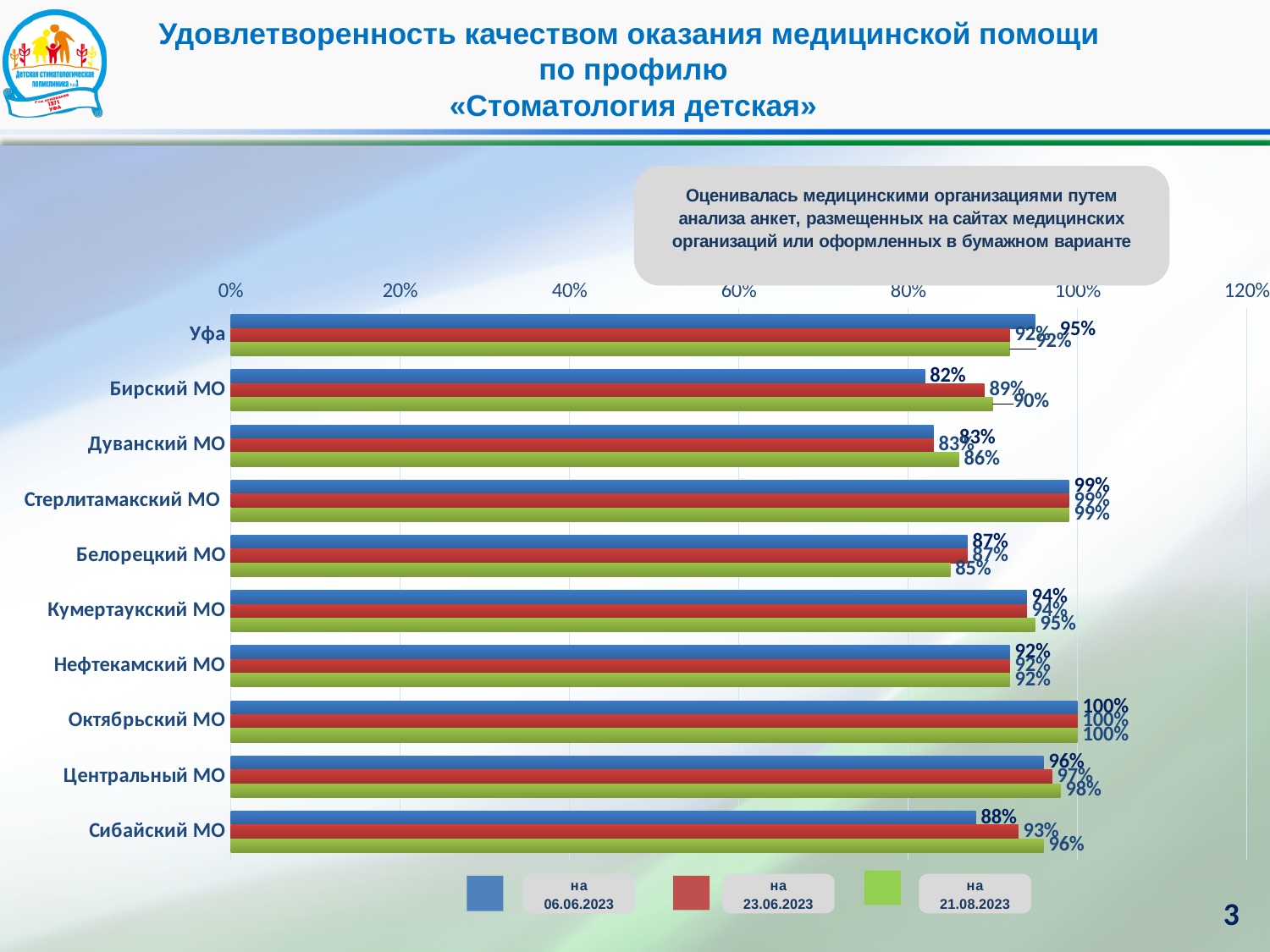
Which category has the highest value for the series на 06.06.2023? Октябрьский МО Is the value for Бирский МО for the series на 06.06.2023 greater or less than 80%? greater How many categories (medical organisations) are plotted on the chart? 10 What is the value for Сибайский МО for the series на 21.08.2023? 96% What is the value for Октябрьский МО for the series на 06.06.2023? 100% How many series does the legend list? 3 What is the difference between the values for Сибайский МО on 21.08.2023 and on 06.06.2023? 8% What kind of chart is shown on the slide? bar chart Which category has the lowest value for the series на 06.06.2023? Бирский МО What is the value for Бирский МО for the series на 06.06.2023? 82% For the series на 06.06.2023, which is larger: the value for Сибайский МО or the value for Бирский МО? Сибайский МО What is the value for Дуванский МО for the series на 21.08.2023? 86%